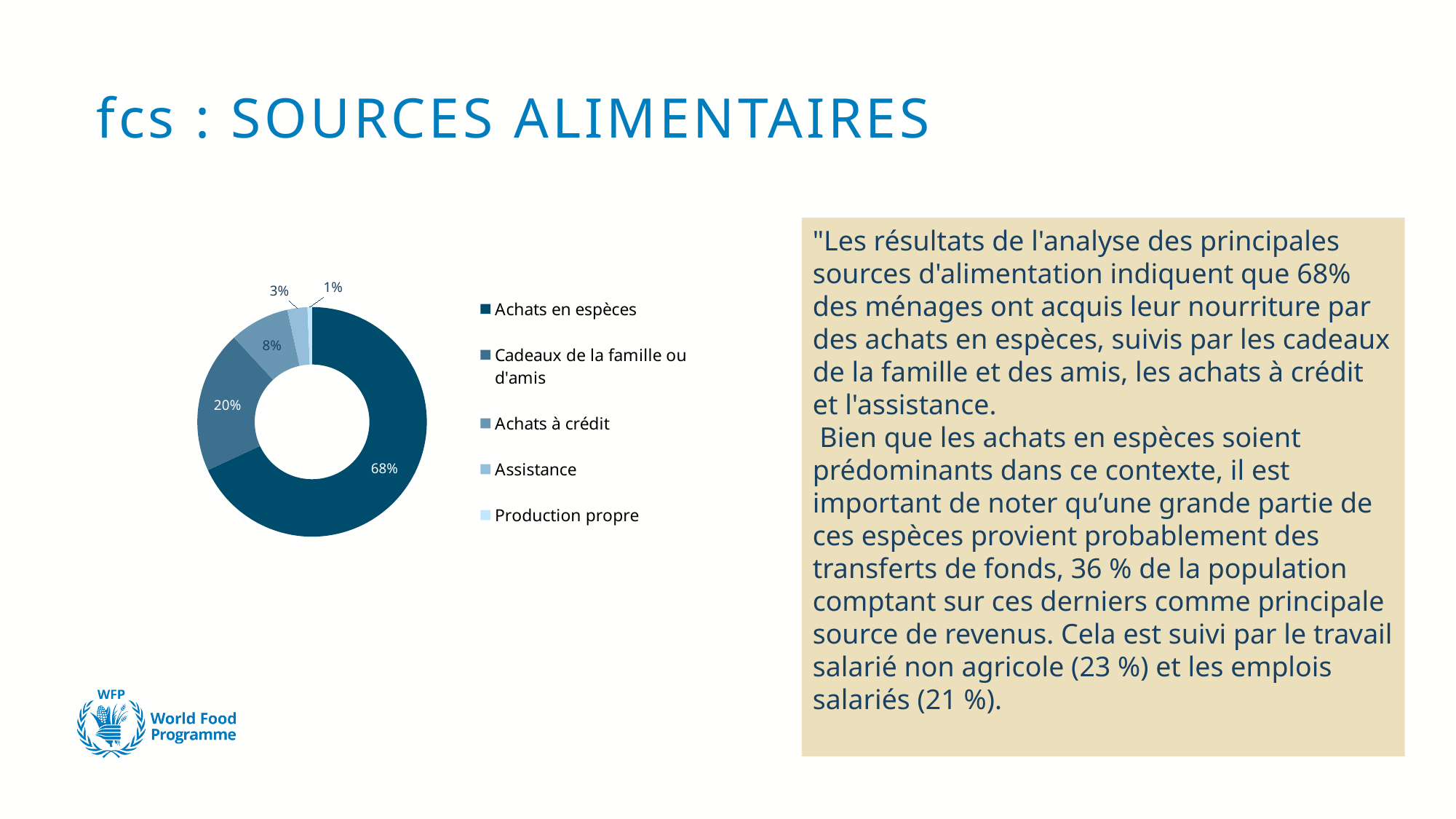
What share of the pie chart is Assistance? 3% What is the title of the slide containing the chart? fcs : SOURCES ALIMENTAIRES Which category has the largest slice in the pie chart? Achats en espèces Which category has the smallest slice in the pie chart? Production propre What is the difference in percentage points between Achats en espèces and Cadeaux de la famille ou d'amis? 48 What share of the pie chart is Cadeaux de la famille ou d'amis? 20% What share of the pie chart is Production propre? 1% What kind of chart is shown on the slide? Doughnut chart Which is larger, Achats à crédit or Assistance? Achats à crédit How many categories does the pie chart show? 5